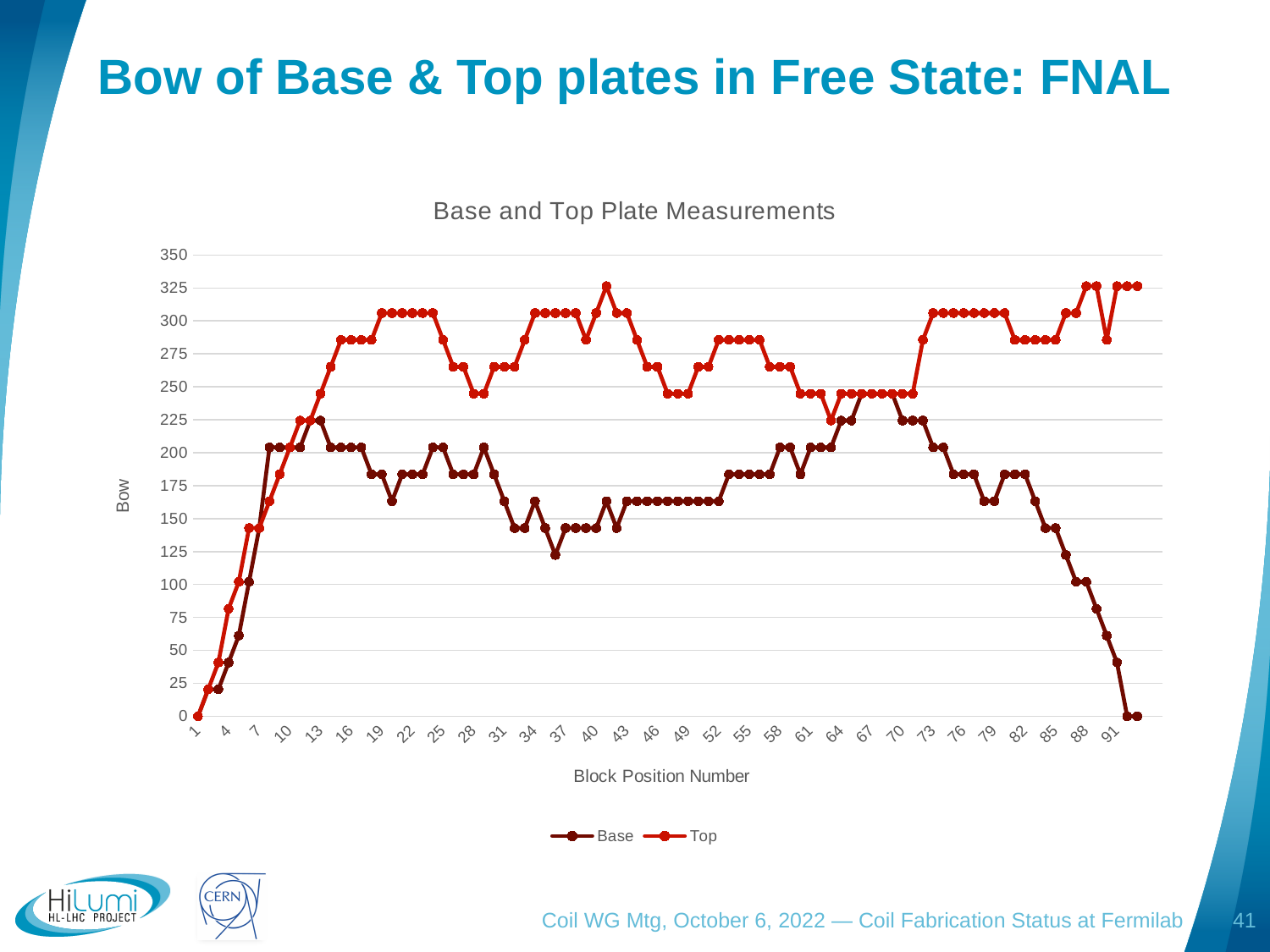
What kind of chart is shown on the slide? line chart Is the Base value at block position 91 greater or less than 100? less At block position 40, which series has the larger value, Base or Top? Top Is the Base value at block position 37 greater or less than 150? less Is the Base value at block position 10 greater or less than 175? greater Do the Base values rise or fall from block position 82 to block position 91? fall What is the label of the x axis? Block Position Number What is the title of the chart? Base and Top Plate Measurements Which series reaches the higher peak value, Base or Top? Top How many series does the legend list? 2 Do the Top values rise or fall from block position 1 to block position 13? rise